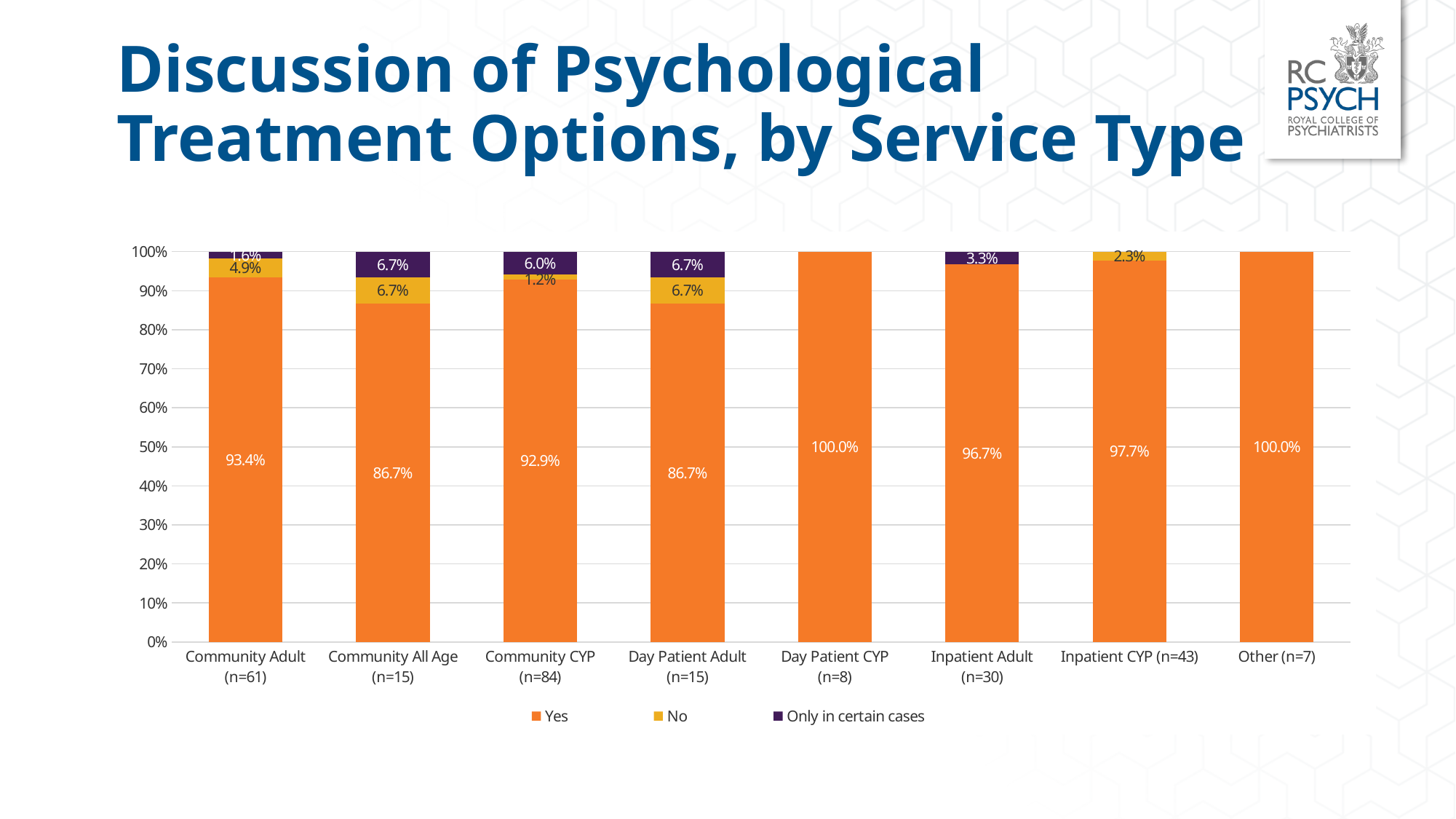
What is the 'No' value for Inpatient CYP (n=43)? 2.3% What kind of chart is shown on the slide? Stacked bar chart How many series does the legend list? 3 Which is larger, the Yes value for Community Adult (n=61) or for Community All Age (n=15)? Community Adult (n=61) What is the Yes value for Inpatient Adult (n=30)? 96.7% What is the difference in percentage points between the Yes values for Inpatient CYP (n=43) and Inpatient Adult (n=30)? 1.0% How many service type categories are shown on the x axis? 8 Is the Yes value for Day Patient Adult (n=15) greater or less than 90%? less What is the 'Only in certain cases' value for Community CYP (n=84)? 6.0% Which colour represents the 'Yes' series in the legend? Orange What percentage of Community Adult (n=61) services answered Yes? 93.4% What is the 'No' value for Community CYP (n=84)? 1.2%